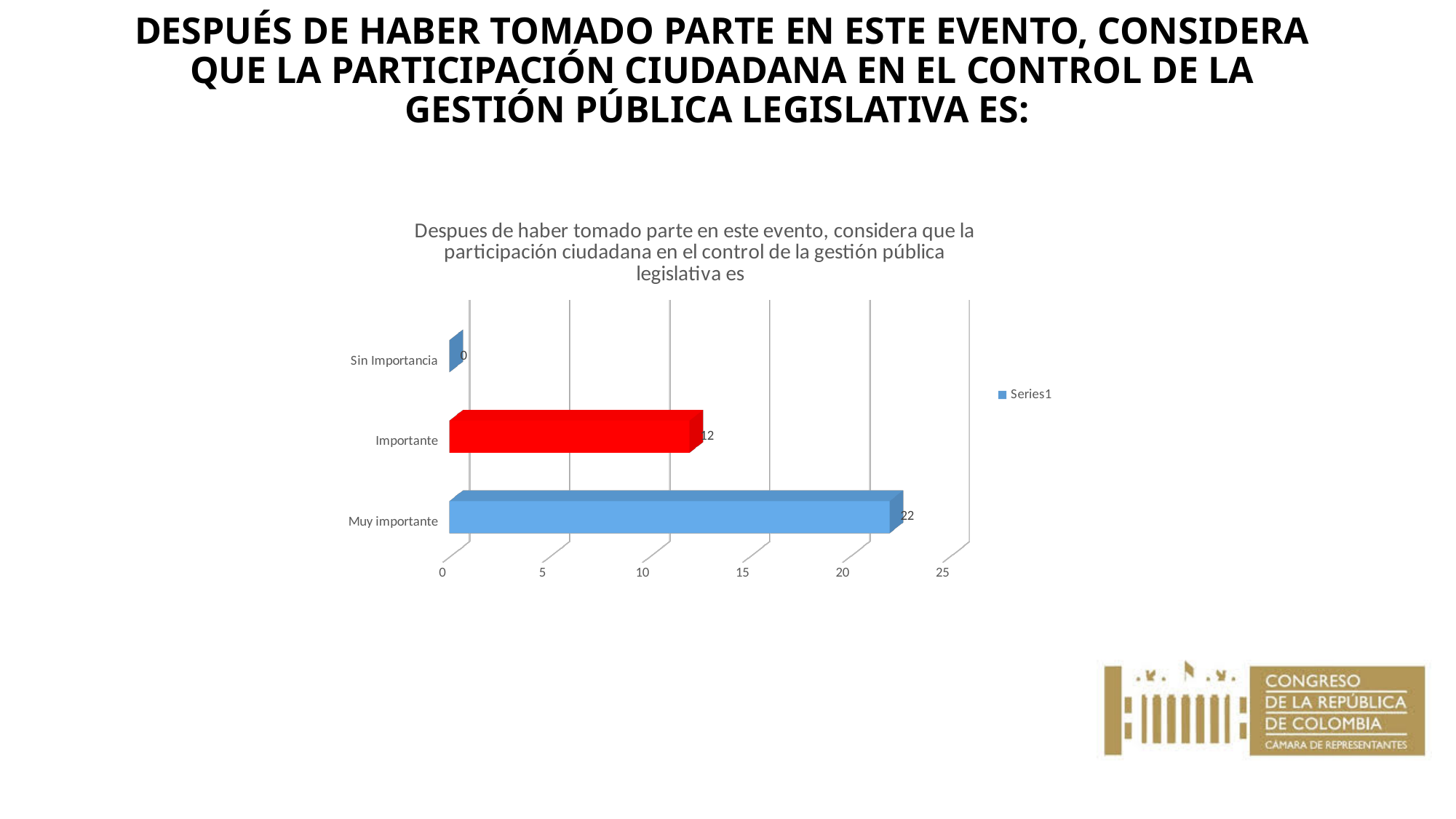
How many series does the legend list? 1 What is the difference between the values for Muy importante and Importante? 10 Is the value for Importante greater or less than 10? greater What kind of chart is shown on the slide? bar chart Which category has the lowest value? Sin Importancia Which is larger, the value for Importante or the value for Muy importante? Muy importante What colour is the bar for Importante? red Which category has the highest value? Muy importante What is the value for Importante? 12 What is the value for Muy importante? 22 How many categories are shown in the chart? 3 What is the value for Sin Importancia? 0